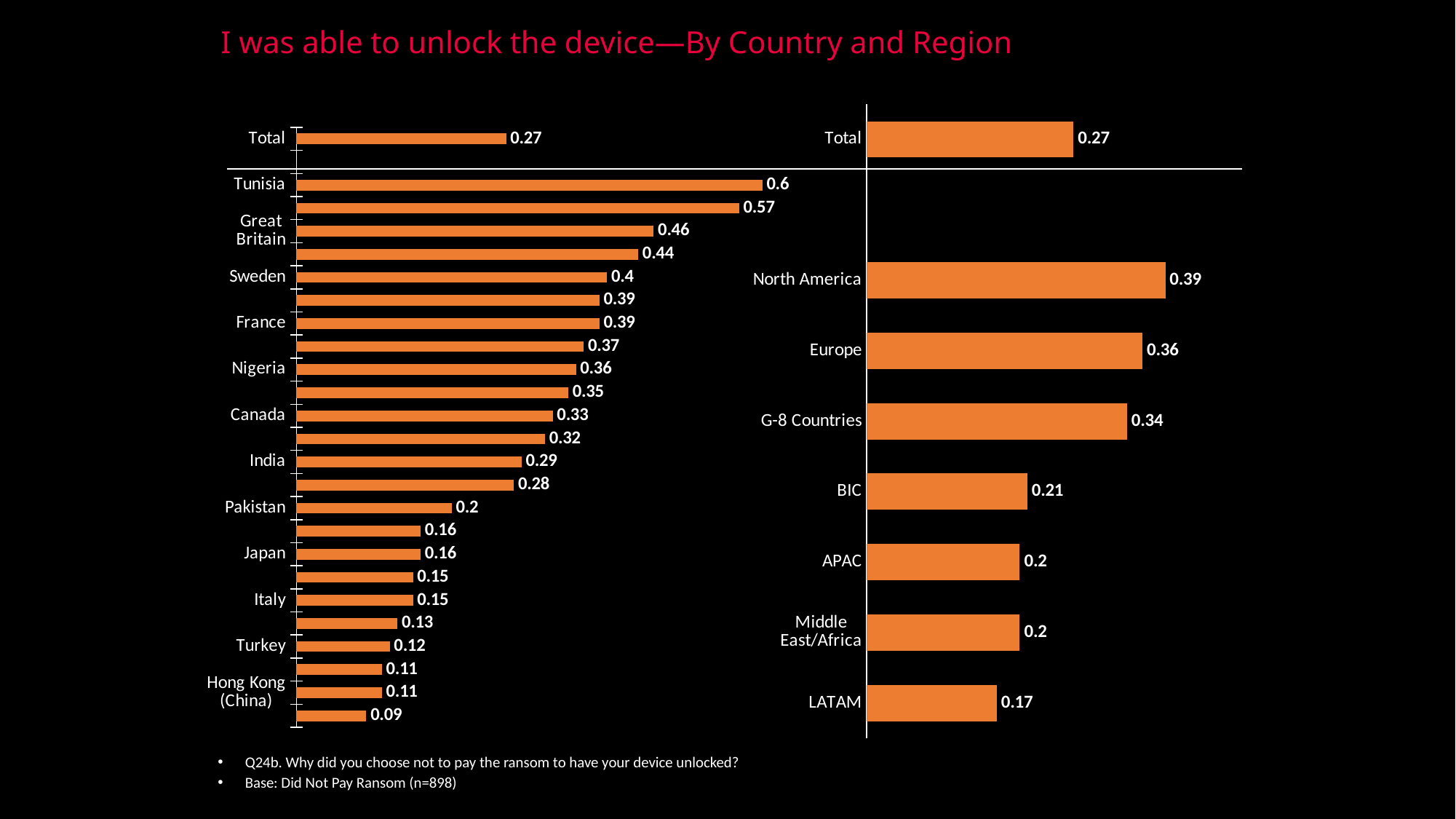
In the left chart (by country), which is larger, the value for Sweden or the value for Canada? Sweden In the left chart (by country), what is the value for Tunisia? 0.6 In the right chart (by region), which region has the lowest value? LATAM In the left chart (by country), what is the value for Great Britain? 0.46 In the right chart (by region), what is the difference between Europe and BIC? 0.15 In the right chart (by region), what is the value for North America? 0.39 In the left chart (by country), what is the value for Pakistan? 0.2 In the right chart (by region), which region has the highest value? North America What kind of chart is used on this slide? Bar chart In the right chart (by region), how many region bars are shown below the Total bar? 7 In the right chart (by region), what is the value for LATAM? 0.17 In the left chart (by country), which labelled country has the highest value? Tunisia